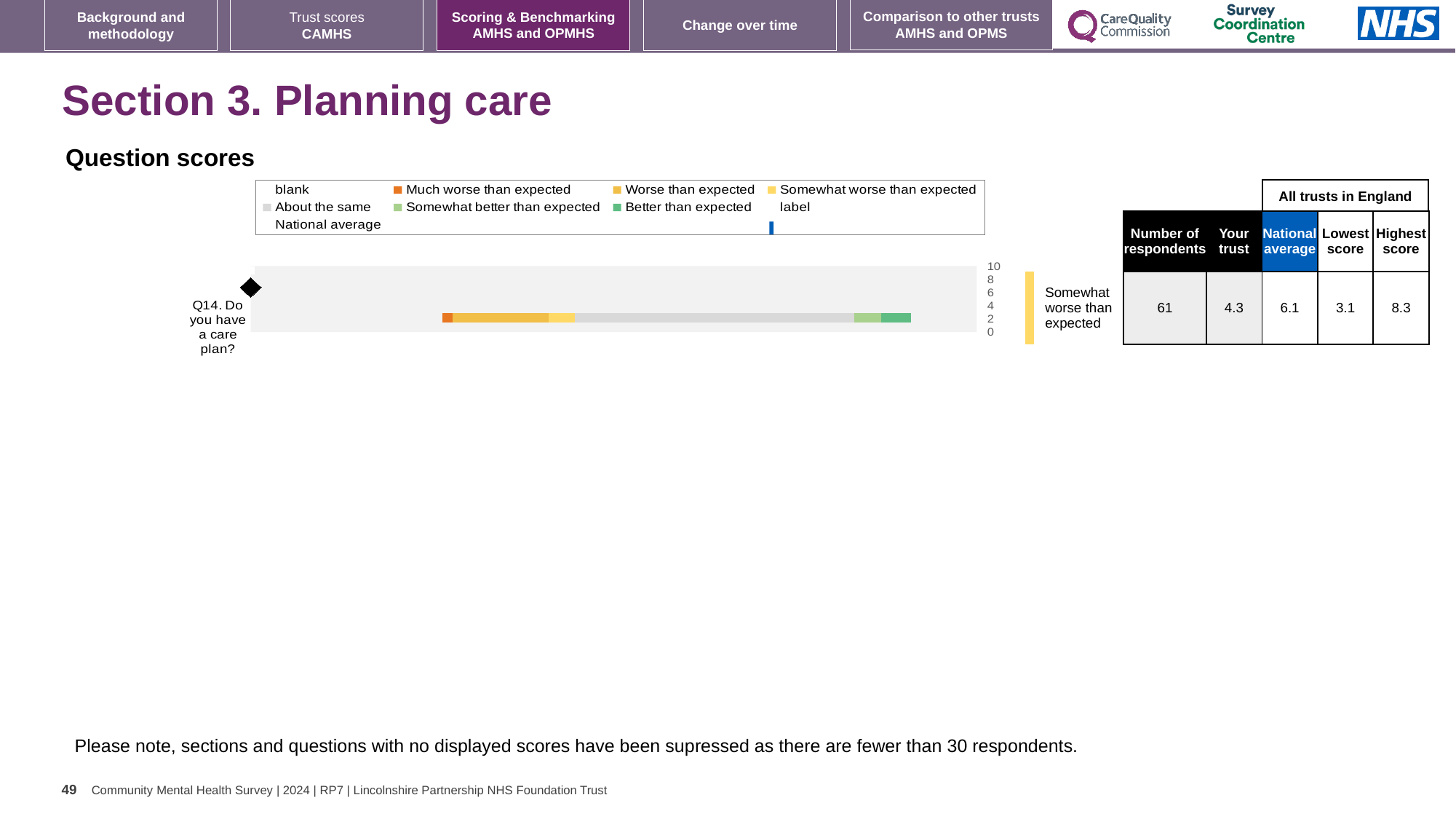
Which is larger for Q14, the trust's score or the national average? National average What is the difference between the highest and lowest scores for Q14? 5.2 Which question is shown in the question scores chart? Q14. Do you have a care plan? What kind of chart is used to show the question scores on this slide? bar chart What is the 'Your trust' score for Q14? 4.3 What is the lowest score among all trusts in England for Q14? 3.1 Is the trust's score for Q14 greater or less than 6? less How many respondents answered Q14? 61 What benchmark category is the trust's Q14 score placed in? Somewhat worse than expected What is the national average score for Q14? 6.1 What is the highest score among all trusts in England for Q14? 8.3 How many questions are plotted in the question scores chart? 1